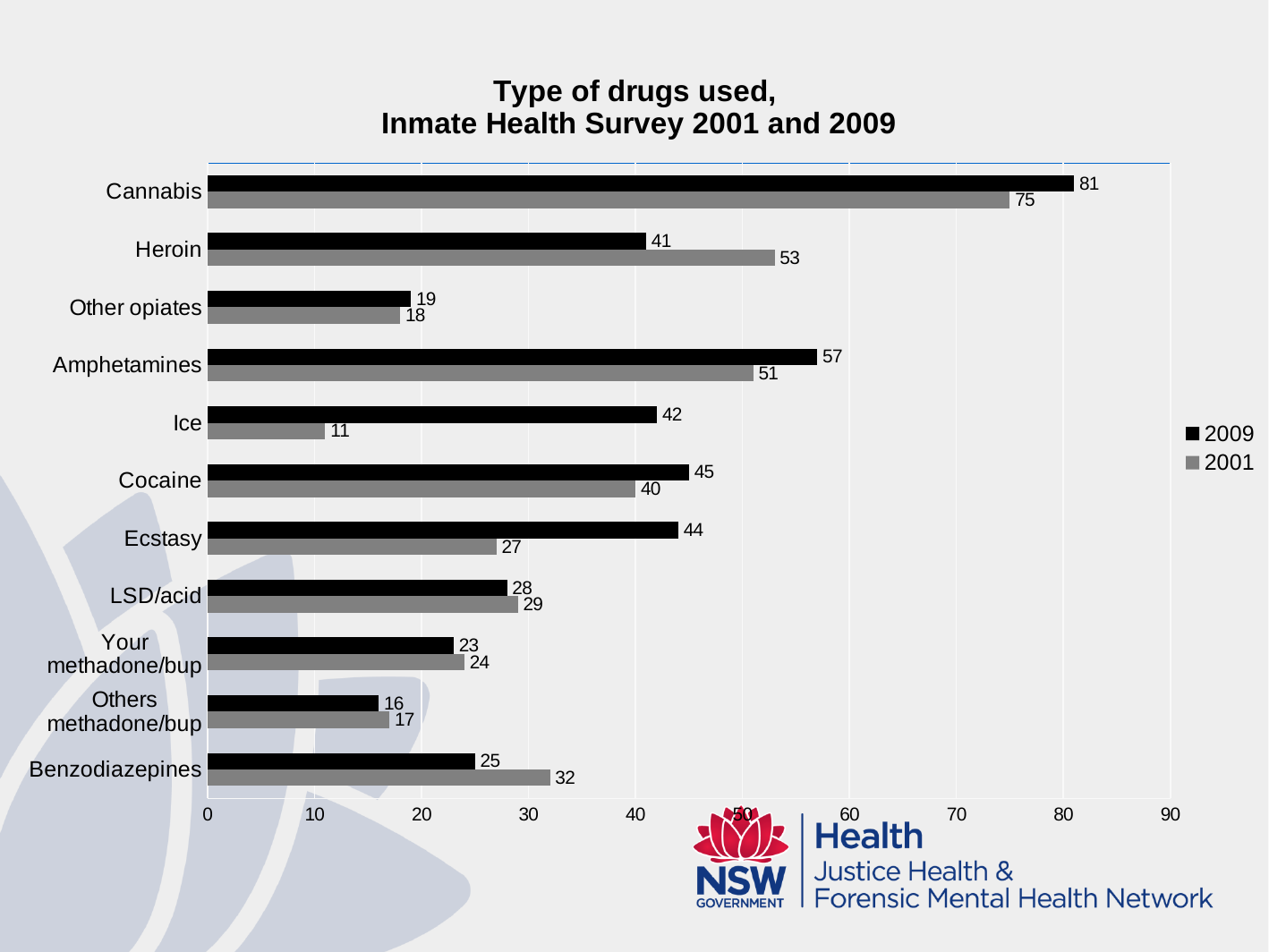
What is the difference between the 2009 and 2001 values for Ice? 31 Which is larger for Benzodiazepines, the 2009 value or the 2001 value? 2001 Which is larger for Ecstasy, the 2009 value or the 2001 value? 2009 Which drug category has the highest 2009 value? Cannabis What is the 2001 value for Ice? 11 What type of chart is shown on the slide? Bar chart How many drug categories are shown on the chart? 11 What is the 2001 value for Heroin? 53 Which drug category has the lowest 2001 value? Ice How many series does the legend list? 2 What is the difference between the 2001 and 2009 values for Heroin? 12 What is the 2009 value for Cannabis? 81